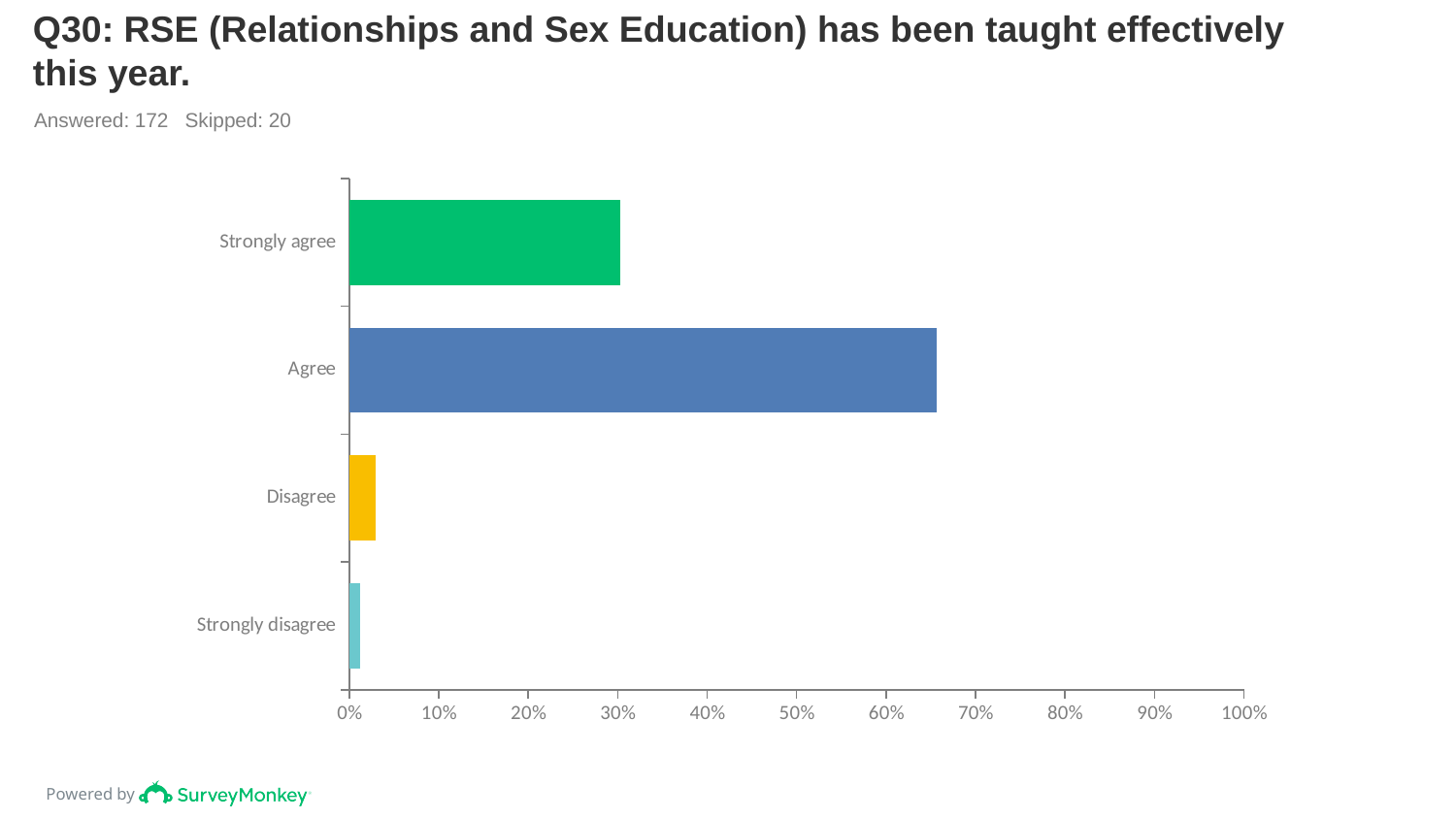
Is the value for Strongly agree greater or less than 40%? less Which category has the lowest value? Strongly disagree Which category has the highest value? Agree What is the maximum value shown on the horizontal axis? 100% What kind of chart is shown on the slide? bar chart Which is larger, the value for Disagree or the value for Strongly disagree? Disagree Is the value for Disagree greater or less than 10%? less How many respondents answered this question according to the slide? 172 How many categories are shown in the chart? 4 Is the value for Agree greater or less than 70%? less Which is larger, the value for Strongly agree or the value for Agree? Agree